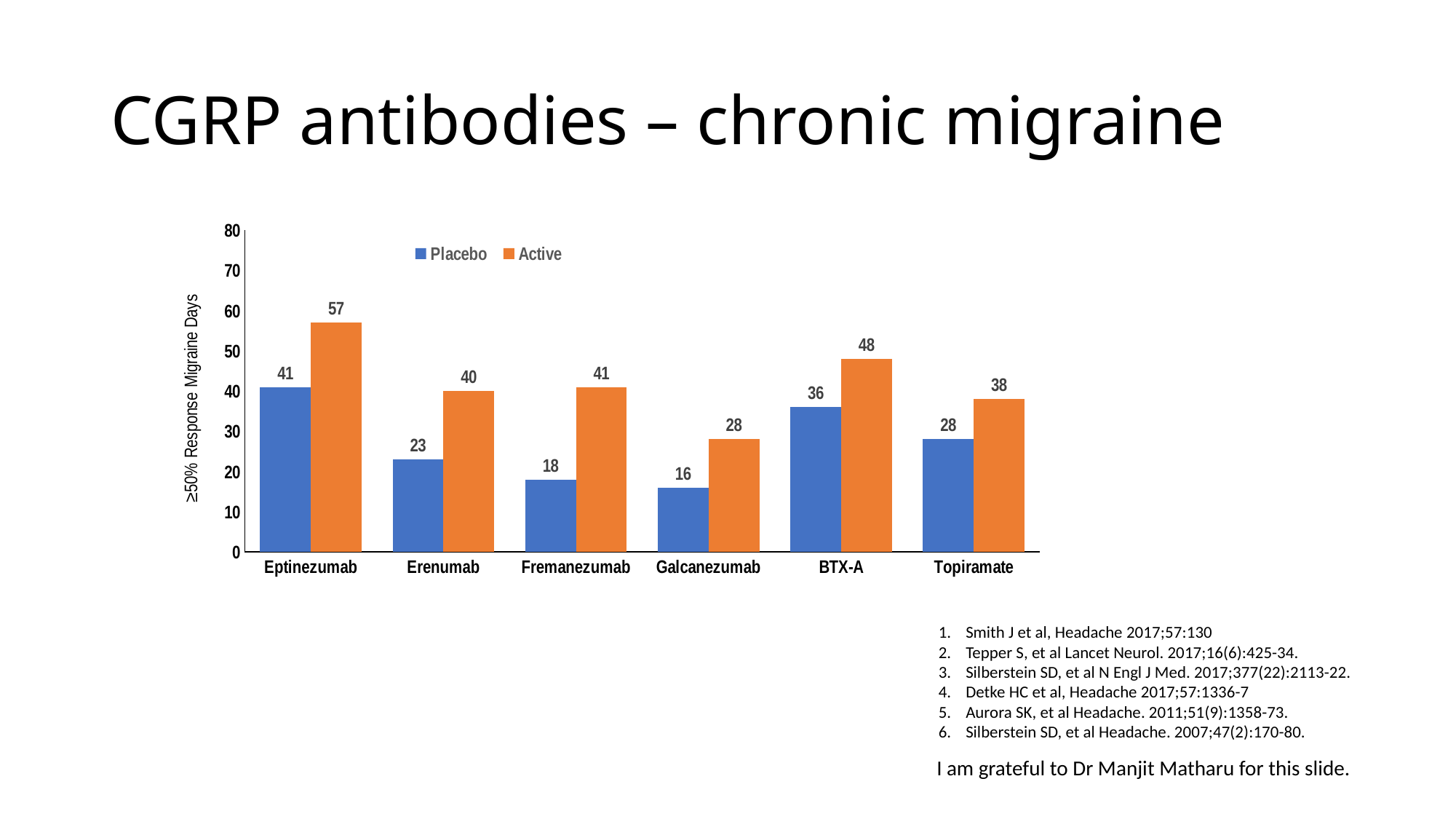
Which category has the highest Active value? Eptinezumab What is the difference between the Active and Placebo values for Erenumab? 17 What is the Placebo value for Galcanezumab? 16 How many series does the legend list? 2 What is the Active value for Eptinezumab? 57 Is the Active value for Galcanezumab greater or less than 30? less Which is larger, the Placebo value for BTX-A or the Placebo value for Topiramate? BTX-A How many categories are shown on the x axis? 6 What is the Active value for BTX-A? 48 What is the label of the y axis? ≥50% Response Migraine Days What kind of chart is shown on the slide? bar chart Which category has the lowest Placebo value? Galcanezumab